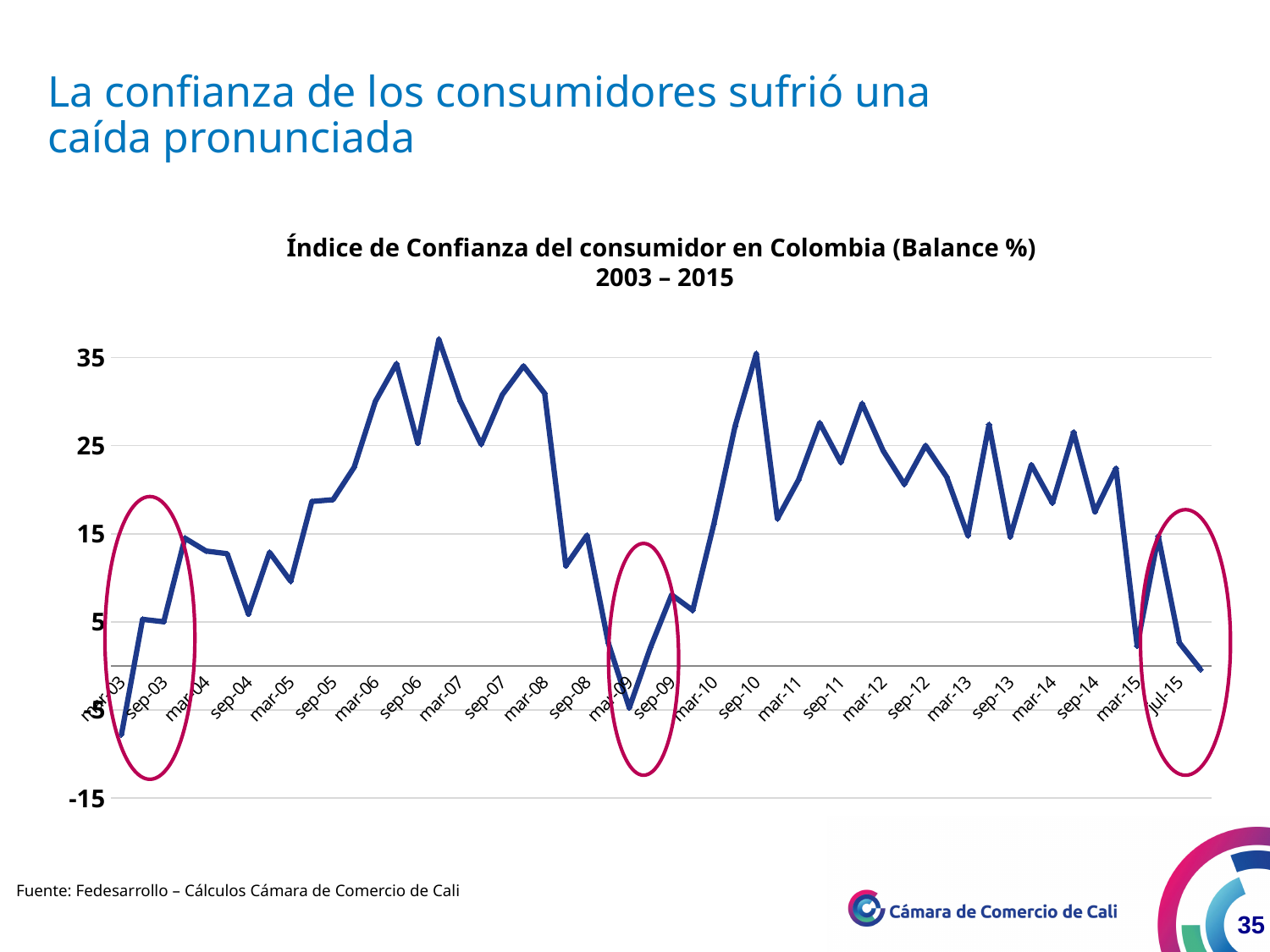
Is the value for mar-06 greater or less than 25? greater Is the value for mar-03 greater or less than -5? less Is the value for mar-07 greater or less than 35? less What kind of chart is shown on the slide? line chart How many red ovals highlight parts of the line on the chart? 3 What is the title of the chart? Índice de Confianza del consumidor en Colombia (Balance %) 2003 – 2015 Which of the two values is larger, mar-07 or sep-08? mar-07